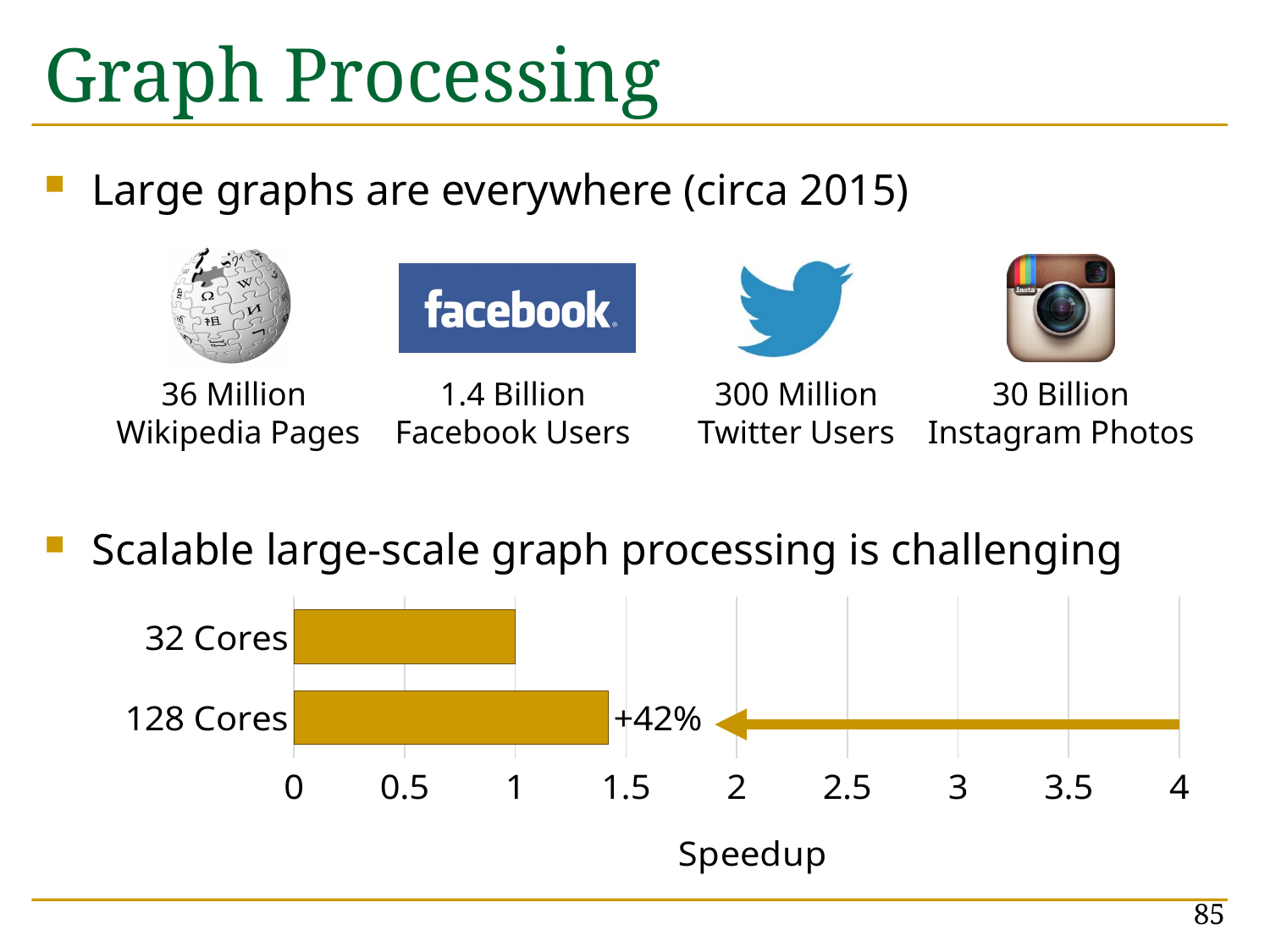
Is the speedup for 128 Cores greater or less than 2? less Which category has the lowest speedup? 32 Cores How many categories are plotted in the chart? 2 What annotation is printed next to the 128 Cores bar? +42% Which category has the highest speedup? 128 Cores What is the label of the x axis? Speedup Which has a larger speedup, 32 Cores or 128 Cores? 128 Cores What is the speedup value for 32 Cores? 1 What type of chart is shown on the slide? bar chart Is the speedup for 128 Cores greater or less than 1? greater